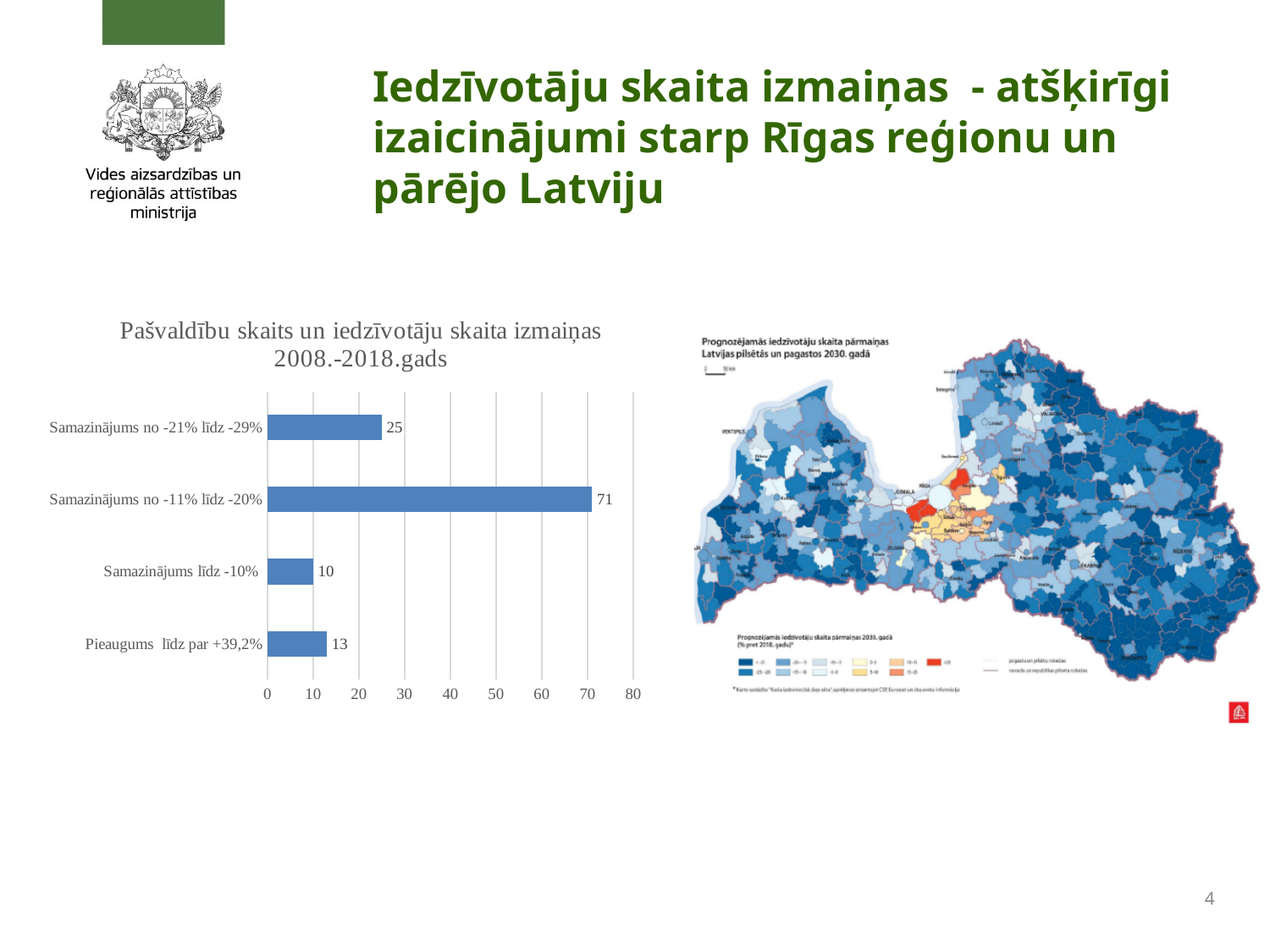
Which is larger in the bar chart: the value for "Pieaugums līdz par +39,2%" or for "Samazinājums līdz -10%"? Pieaugums līdz par +39,2% What is the title of the bar chart? Pašvaldību skaits un iedzīvotāju skaita izmaiņas 2008.-2018.gads Is the value for "Samazinājums no -11% līdz -20%" greater or less than 60? greater What kind of chart is shown on the left of the slide? bar chart What is the difference between the values for "Samazinājums no -11% līdz -20%" and "Samazinājums no -21% līdz -29%" in the bar chart? 46 What is the value for "Samazinājums no -21% līdz -29%" in the bar chart? 25 What is the value for "Samazinājums līdz -10%" in the bar chart? 10 How many categories are shown in the bar chart? 4 Which category has the lowest value in the bar chart? Samazinājums līdz -10% What is the value for "Pieaugums līdz par +39,2%" in the bar chart? 13 What is the value for "Samazinājums no -11% līdz -20%" in the bar chart? 71 Which category has the highest value in the bar chart? Samazinājums no -11% līdz -20%